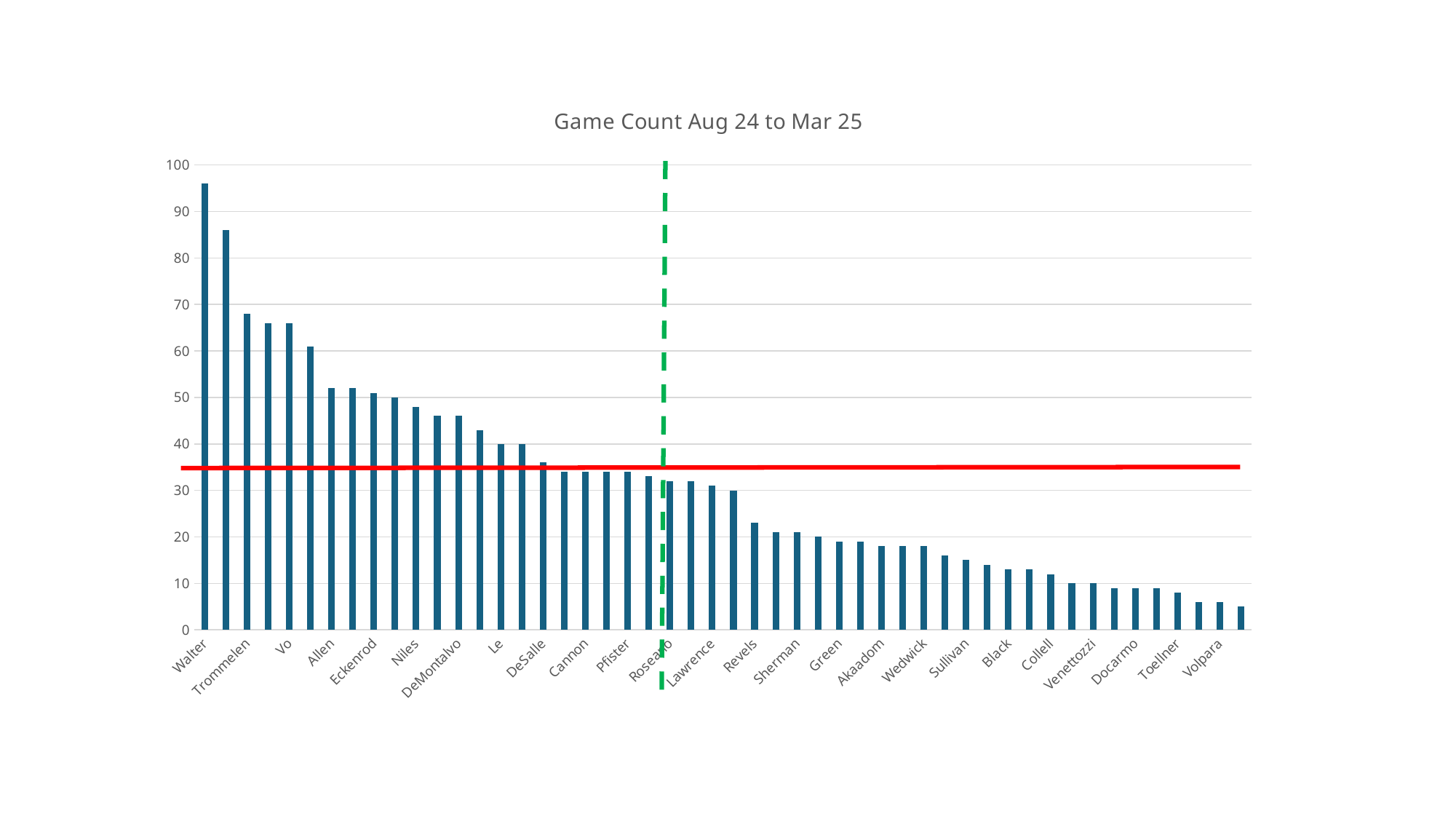
What is the title of the chart? Game Count Aug 24 to Mar 25 Is the value for Niles greater or less than 50? less Is the value for Sullivan greater or less than 20? less Which has a higher game count, Vo or Revels? Vo What type of chart is shown on the slide? bar chart Is the value for Walter greater or less than 90? greater Which category has the highest game count? Walter Do the values rise or fall moving from left to right along the x axis? fall